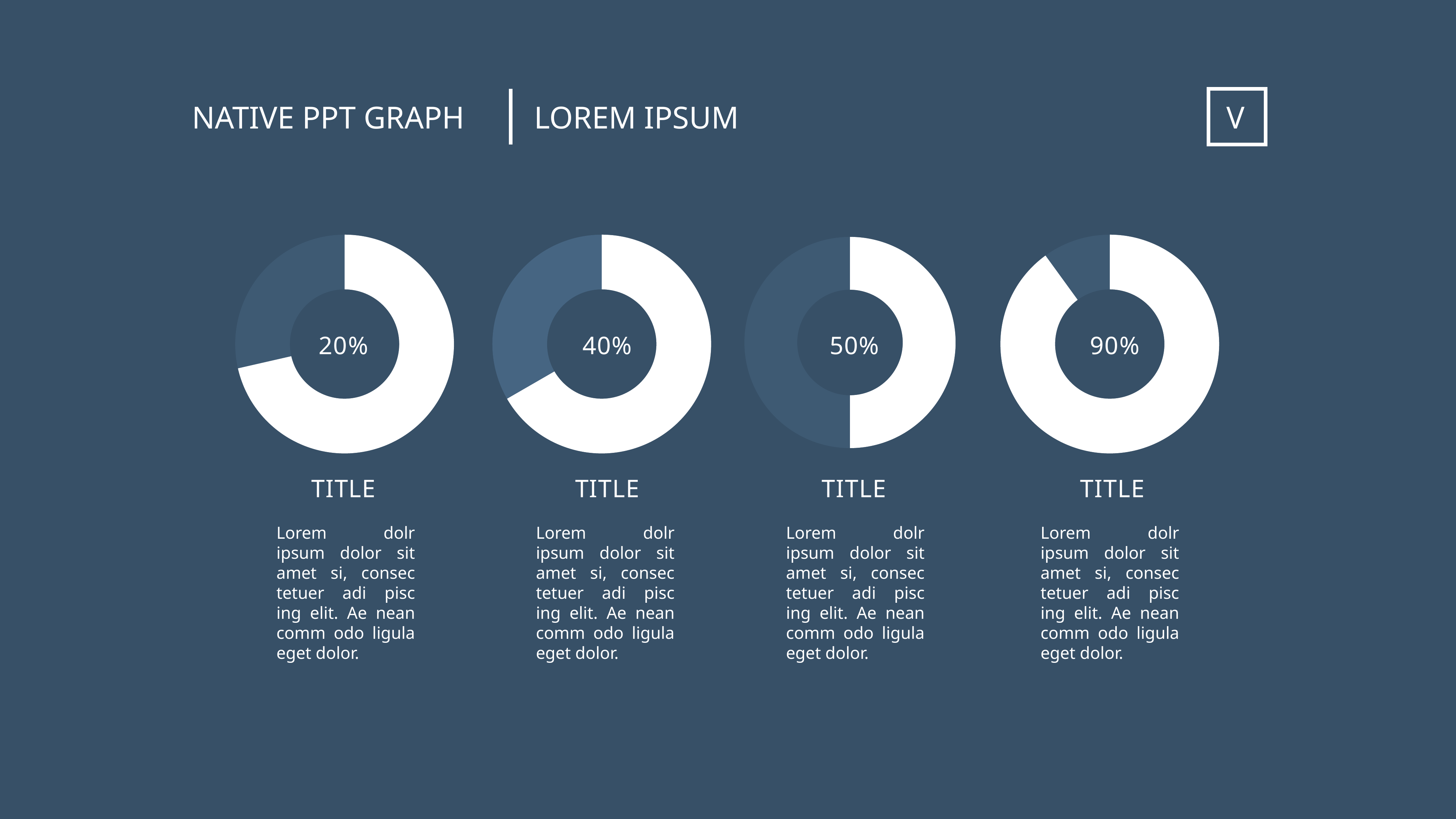
What percentage is shown in the centre of the third donut chart from the left? 50% How many donut charts are shown on the slide? 4 What percentage is shown in the centre of the second donut chart from the left? 40% What percentage is shown in the centre of the rightmost donut chart? 90% What is the difference between the percentage in the rightmost donut chart and the percentage in the leftmost donut chart? 70% Which of the four donut charts shows the lowest percentage? The leftmost chart (20%) What kind of chart is used for each of the four graphics on the slide? Donut chart What is the difference between the percentages shown in the third and second donut charts from the left? 10% What percentage is shown in the centre of the leftmost donut chart? 20% Which of the four donut charts shows the highest percentage? The rightmost chart (90%) Which shows a larger percentage, the second donut chart from the left or the third donut chart from the left? The third chart (50%) Do the percentages in the donut charts increase or decrease from left to right across the slide? Increase